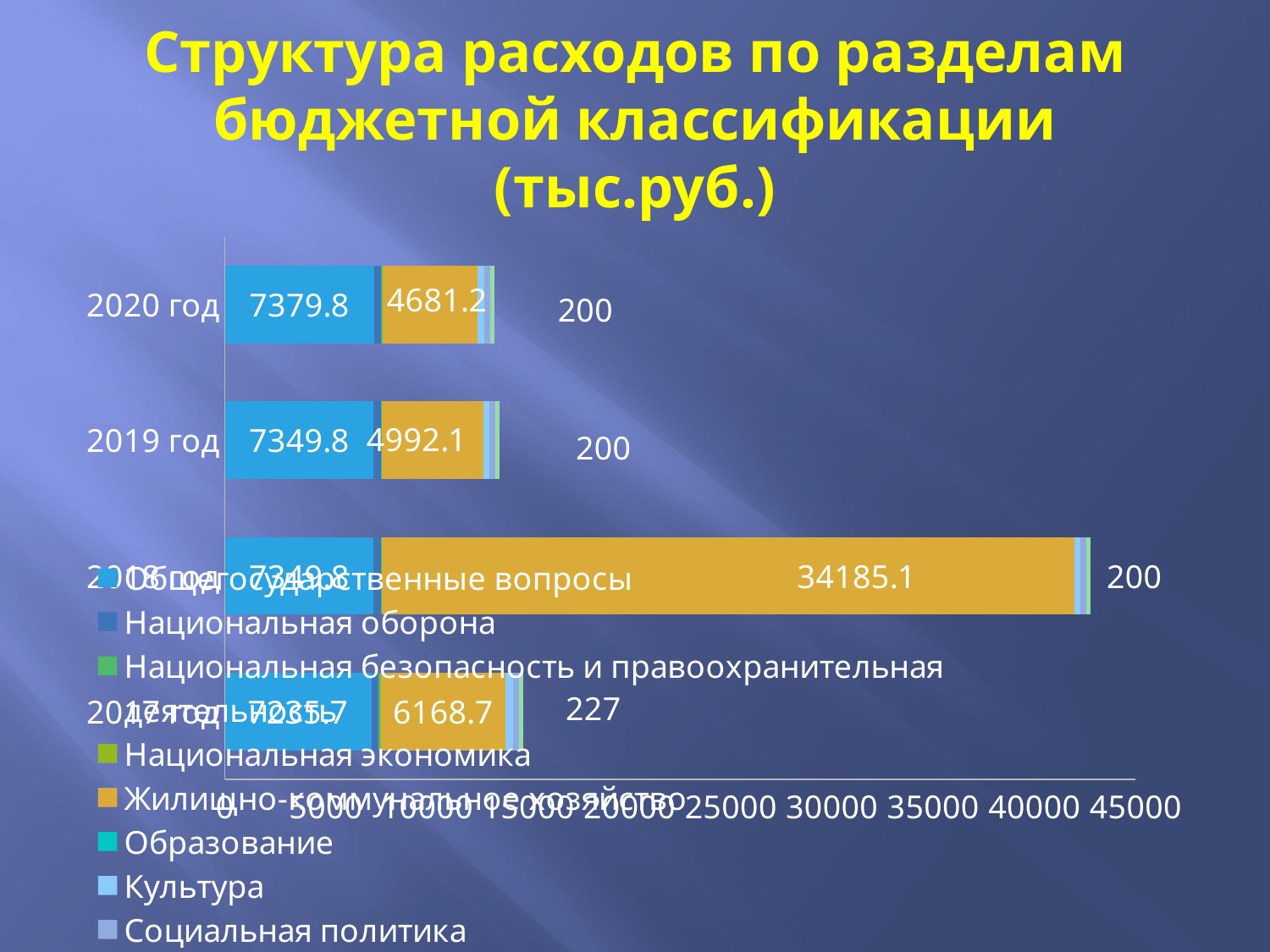
Which is larger, the Общегосударственные вопросы value for 2020 год or for 2019 год? 2020 год What kind of chart is shown on the slide? bar chart What is the title of the chart on the slide? Структура расходов по разделам бюджетной классификации (тыс.руб.) Which year has the highest value for Жилищно-коммунальное хозяйство? 2018 год Which year has the lowest value for Общегосударственные вопросы? 2017 год What is the value for Жилищно-коммунальное хозяйство in 2018 год? 34185.1 What is the value for Жилищно-коммунальное хозяйство in 2017 год? 6168.7 What is the difference between the Жилищно-коммунальное хозяйство values for 2019 год and 2020 год? 310.9 How many series does the legend list? 8 How many years (categories) are plotted on the chart? 4 What is the value for Общегосударственные вопросы in 2020 год? 7379.8 What is the difference between the Общегосударственные вопросы values for 2020 год and 2017 год? 144.1